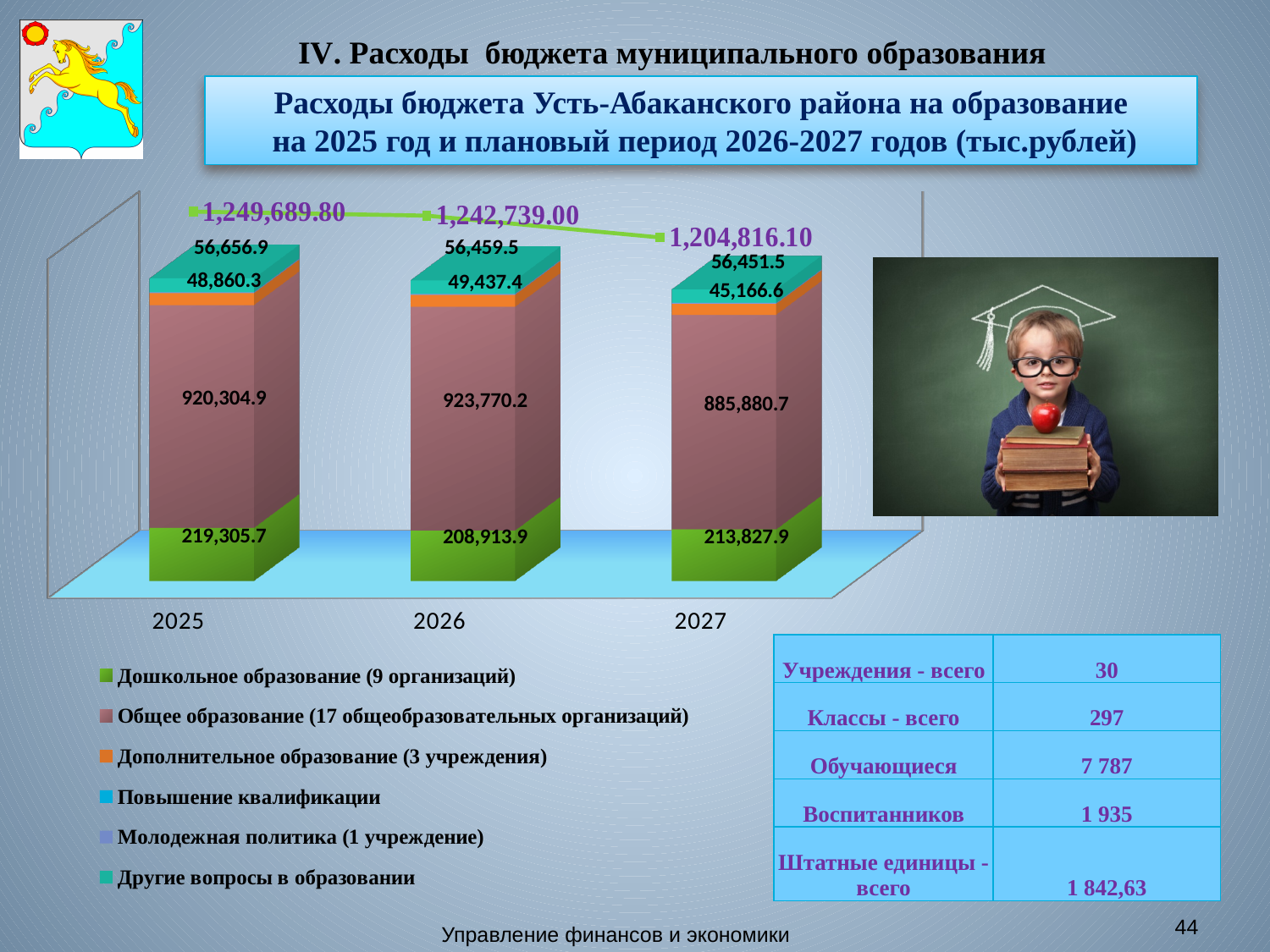
By how much does Общее образование in 2026 exceed Общее образование in 2025? 3,465.3 What is the value for Дошкольное образование in 2025? 219,305.7 How many series does the chart legend list? 6 What kind of chart is used to show the education expenditure? Stacked bar chart Do the total expenditure values rise or fall from 2025 to 2027? Fall How many years are shown on the x axis of the chart? 3 What is the total education expenditure shown for 2026? 1,242,739.00 Which is larger: Дошкольное образование in 2026 or in 2027? 2027 What is the value for Общее образование in 2027? 885,880.7 What is the difference between the total for 2025 and the total for 2027? 44,873.70 In which year is the value for Общее образование the lowest? 2027 Which year has the highest total education expenditure? 2025